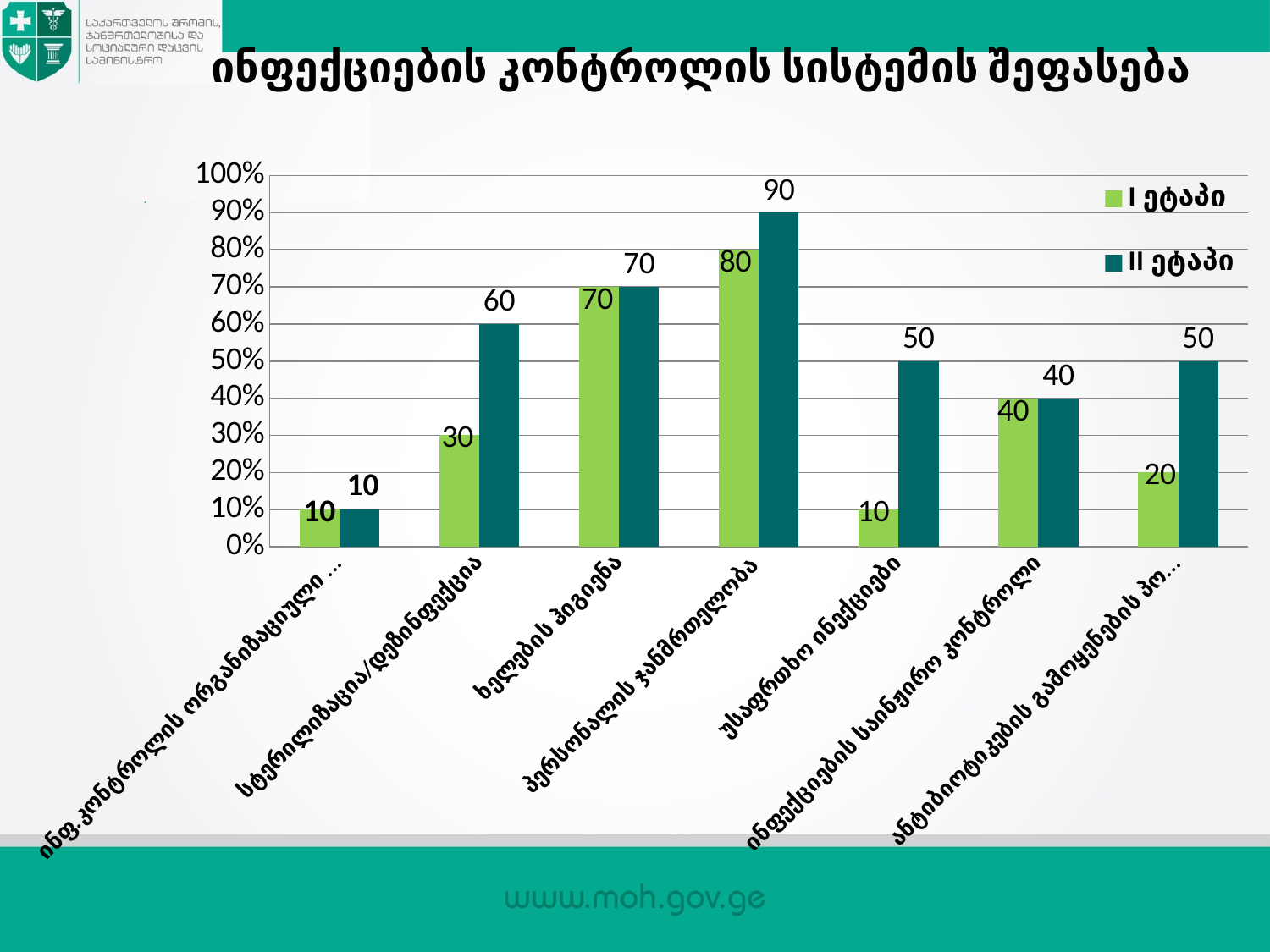
Which category has the lowest value for I ეტაპი? ინფ.კონტროლის ორგანიზაციული ... and უსაფრთხო ინექციები (both 10) What is the value for I ეტაპი in the category პერსონალის ჯანმრთელობა? 80 Which category has the highest value for II ეტაპი? პერსონალის ჯანმრთელობა Is the value for II ეტაპი in the category ხელების ჰიგიენა greater or less than 50%? greater In the category სტერილიზაცია/დეზინფექცია, which series has the larger value, I ეტაპი or II ეტაპი? II ეტაპი How many series does the legend list? 2 How many categories are shown on the x axis? 7 What type of chart is shown on the slide? bar chart What is the value for II ეტაპი in the category უსაფრთხო ინექციები? 50 What is the value for II ეტაპი in the category სტერილიზაცია/დეზინფექცია? 60 What are the two legend entries of the chart? I ეტაპი and II ეტაპი What is the difference between II ეტაპი and I ეტაპი in the category უსაფრთხო ინექციები? 40